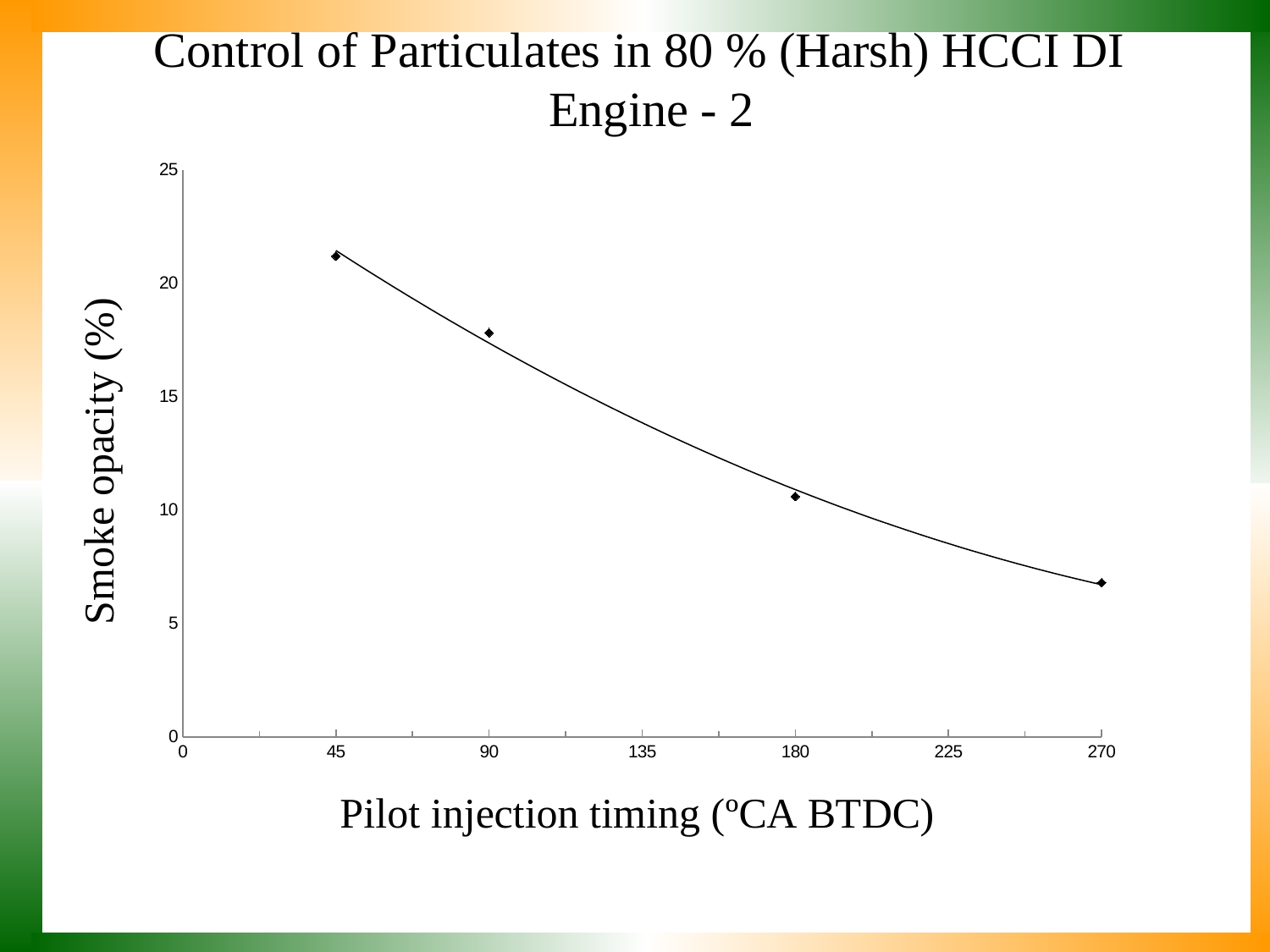
What kind of chart is shown on the slide? scatter chart with a trend line At which pilot injection timing is smoke opacity highest? 45 At which pilot injection timing is smoke opacity lowest? 270 Is the smoke opacity at a pilot injection timing of 45 greater or less than 20? greater What is the label of the y axis? Smoke opacity (%) Is the smoke opacity at a pilot injection timing of 270 greater or less than 10? less How many data points are plotted on the chart? 4 Which has the higher smoke opacity: pilot injection timing of 90 or 180? 90 Does smoke opacity rise or fall as pilot injection timing increases along the x axis? fall What is the label of the x axis? Pilot injection timing (ºCA BTDC) Is the smoke opacity at a pilot injection timing of 90 greater or less than 15? greater